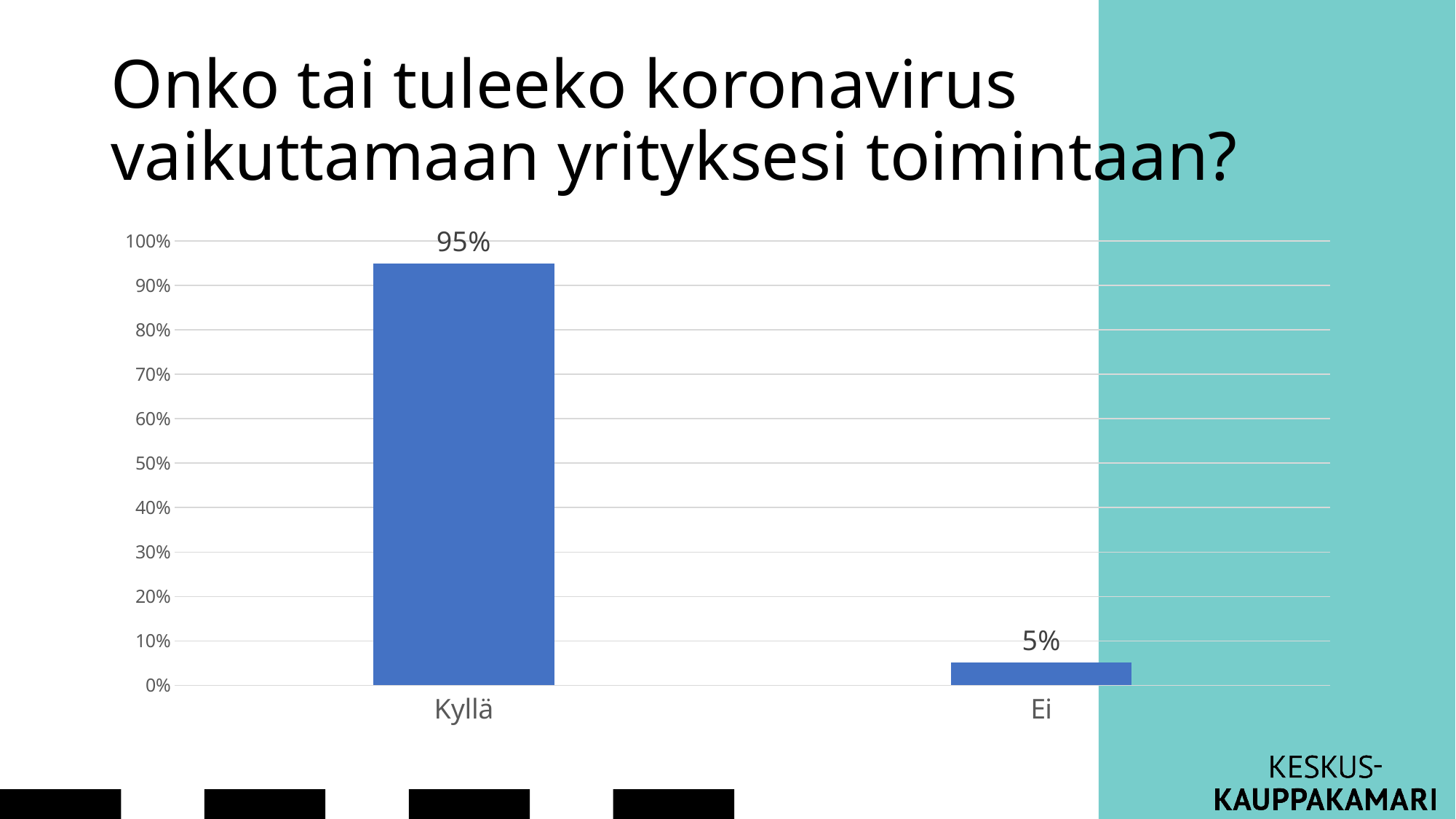
How many categories are shown on the x axis? 2 What kind of chart is shown on the slide? bar chart What is the value for Kyllä? 95% What is the title of the slide above the chart? Onko tai tuleeko koronavirus vaikuttamaan yrityksesi toimintaan? What is the difference between the values for Kyllä and Ei? 90% Which category has the lowest value? Ei What is the highest value shown on the y axis? 100% What is the value for Ei? 5% Which is larger, the value for Kyllä or the value for Ei? Kyllä Which category has the highest value? Kyllä Is the value for Kyllä greater or less than 90%? greater Is the value for Ei greater or less than 10%? less